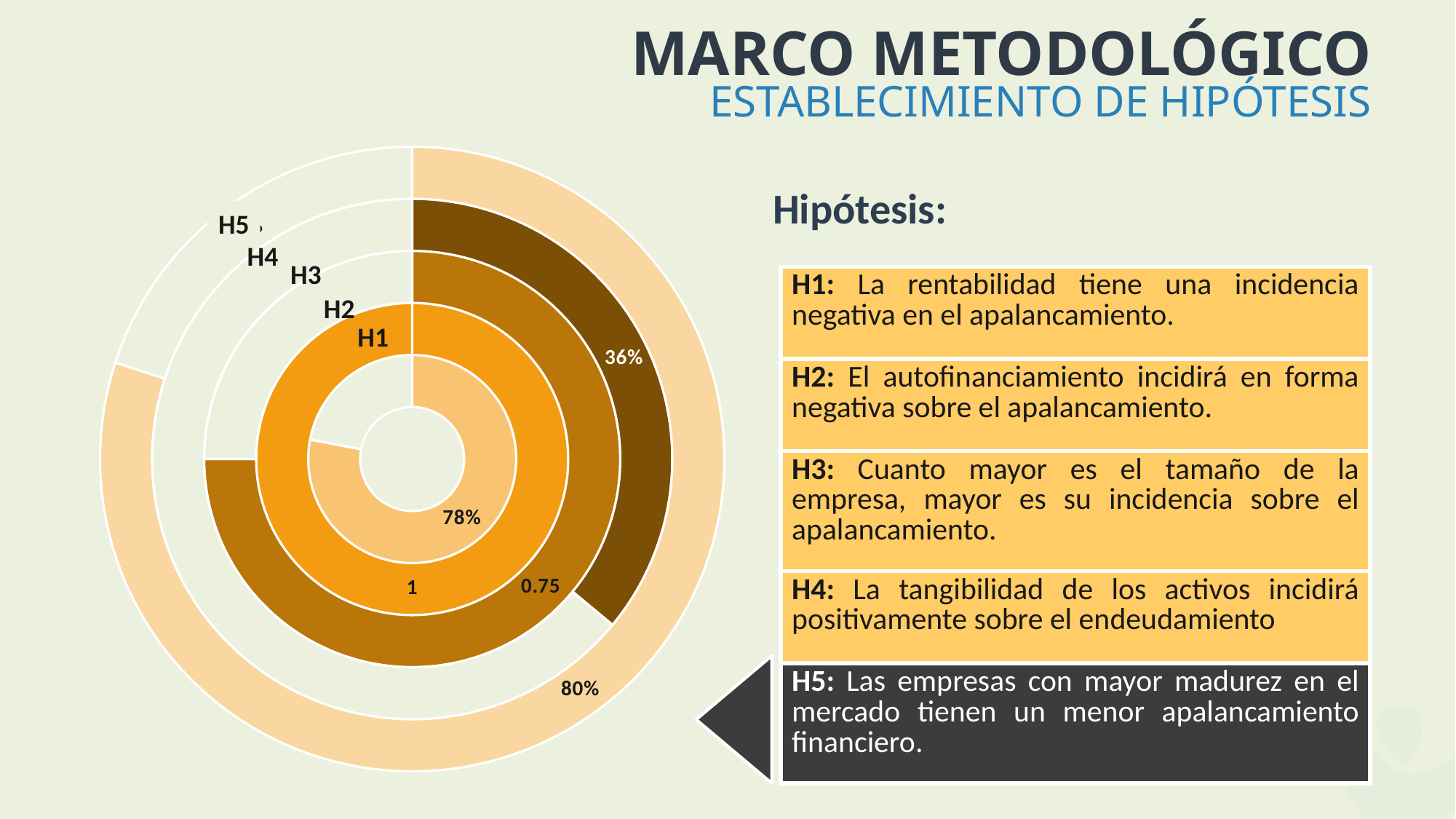
Which is larger, the value for H1 or the value for H4? H1 Which ring of the chart forms a complete circle? H2 What kind of chart is shown on the slide? doughnut chart Which ring of the chart has the shortest arc (lowest value)? H4 What value is shown on the H4 ring of the chart? 36% What value is shown on the H2 ring of the chart? 1 How many rings (hypotheses) does the chart show? 5 Which is larger, the value for H5 or the value for H4? H5 What value is shown on the H1 ring of the chart? 78% What value is shown on the H3 ring of the chart? 0.75 What value is shown on the H5 (outermost) ring of the chart? 80% Which hypothesis label is on the innermost ring of the chart? H1